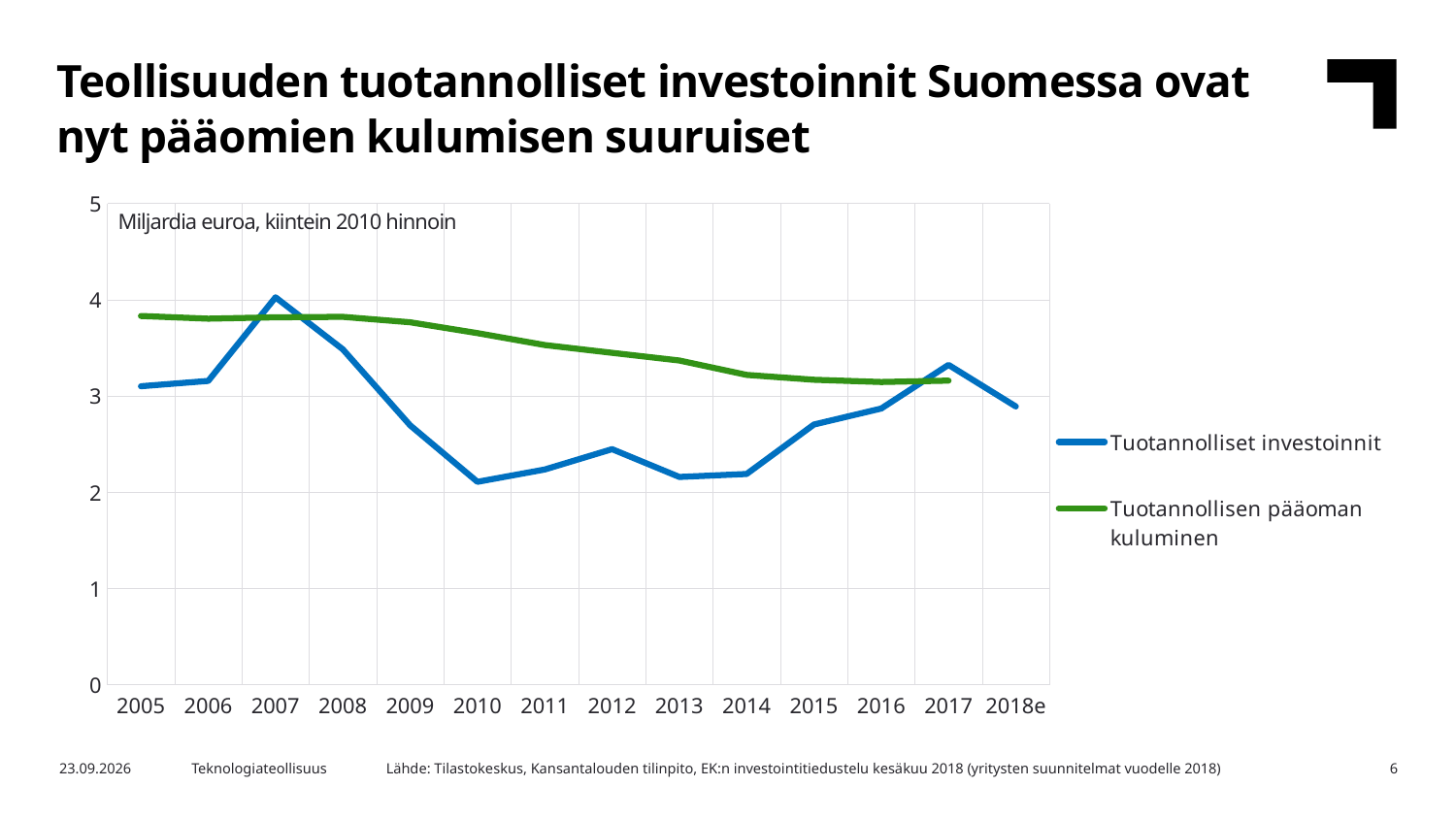
Does the Tuotannolliset investoinnit line rise or fall from 2007 to 2010? fall Is the value for Tuotannolliset investoinnit in 2009 greater or less than 3? less Does the Tuotannollisen pääoman kuluminen line rise or fall from 2005 to 2017? fall Is the value for Tuotannollisen pääoman kuluminen in 2012 greater or less than 3? greater In which year does the Tuotannolliset investoinnit line reach its highest value? 2007 How many years are shown on the x axis? 14 In 2010, which series has the larger value, Tuotannolliset investoinnit or Tuotannollisen pääoman kuluminen? Tuotannollisen pääoman kuluminen Is the value for Tuotannolliset investoinnit in 2010 greater or less than 3? less What kind of chart is shown on the slide? line chart In 2007, which series has the larger value, Tuotannolliset investoinnit or Tuotannollisen pääoman kuluminen? Tuotannolliset investoinnit How many series does the legend list? 2 What unit is stated in the label inside the chart area? Miljardia euroa, kiintein 2010 hinnoin